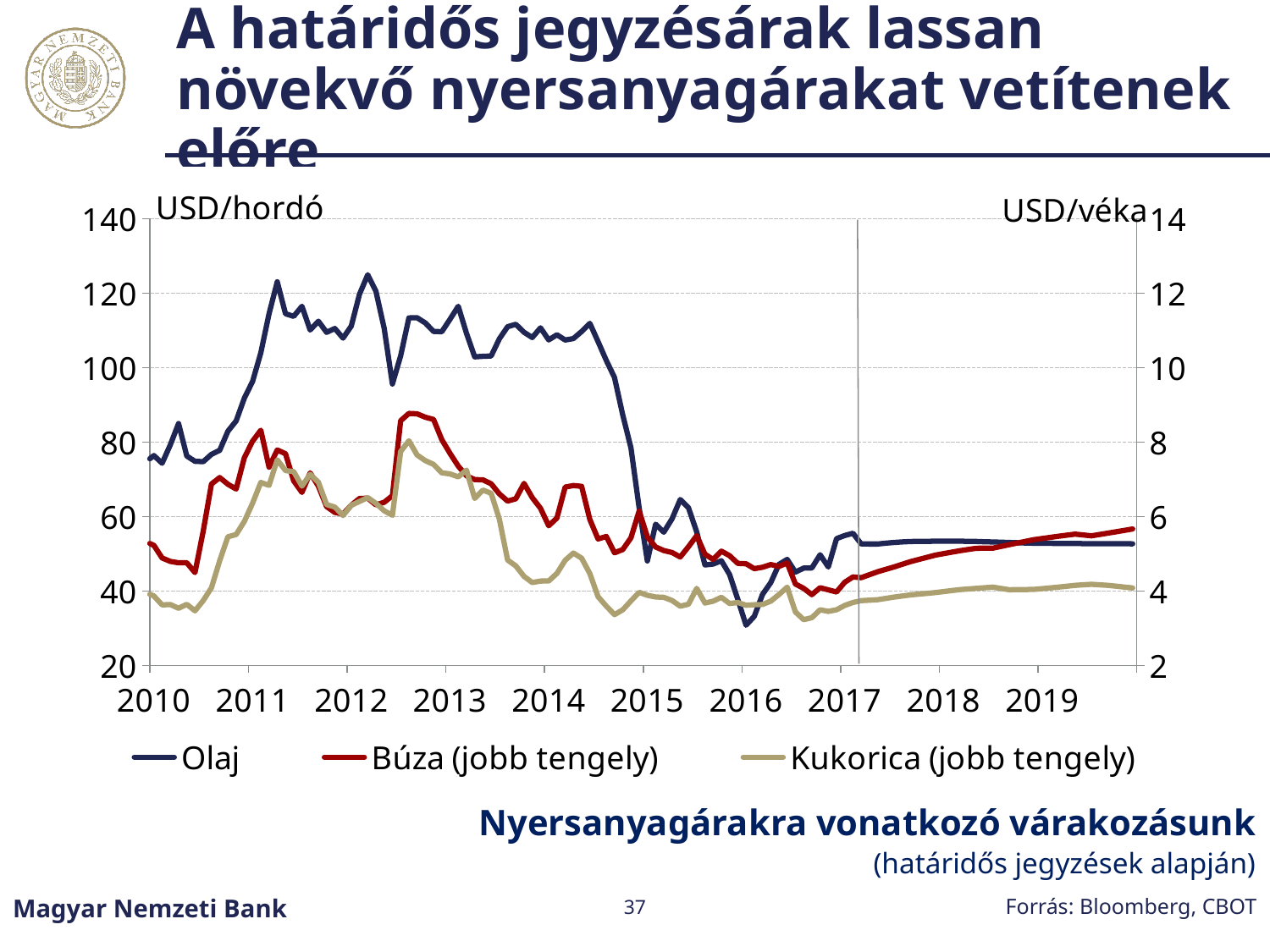
Does the Búza series rise or fall between 2017 and 2019? rise Is the value for Olaj at the start of 2010 greater or less than 100? less Which is higher for Olaj: the value in 2013 or the value in 2016? 2013 What unit is shown on the left axis of the chart? USD/hordó Which series are plotted on the right axis (jobb tengely)? Búza and Kukorica Is the value for Kukorica in 2015 greater or less than 6 on the right axis? less Is the peak value for Búza in 2012 greater or less than 8 on the right axis? greater What kind of chart is shown on the slide? line chart Does the Olaj series rise or fall between mid-2014 and early 2016? fall How many series does the legend list? 3